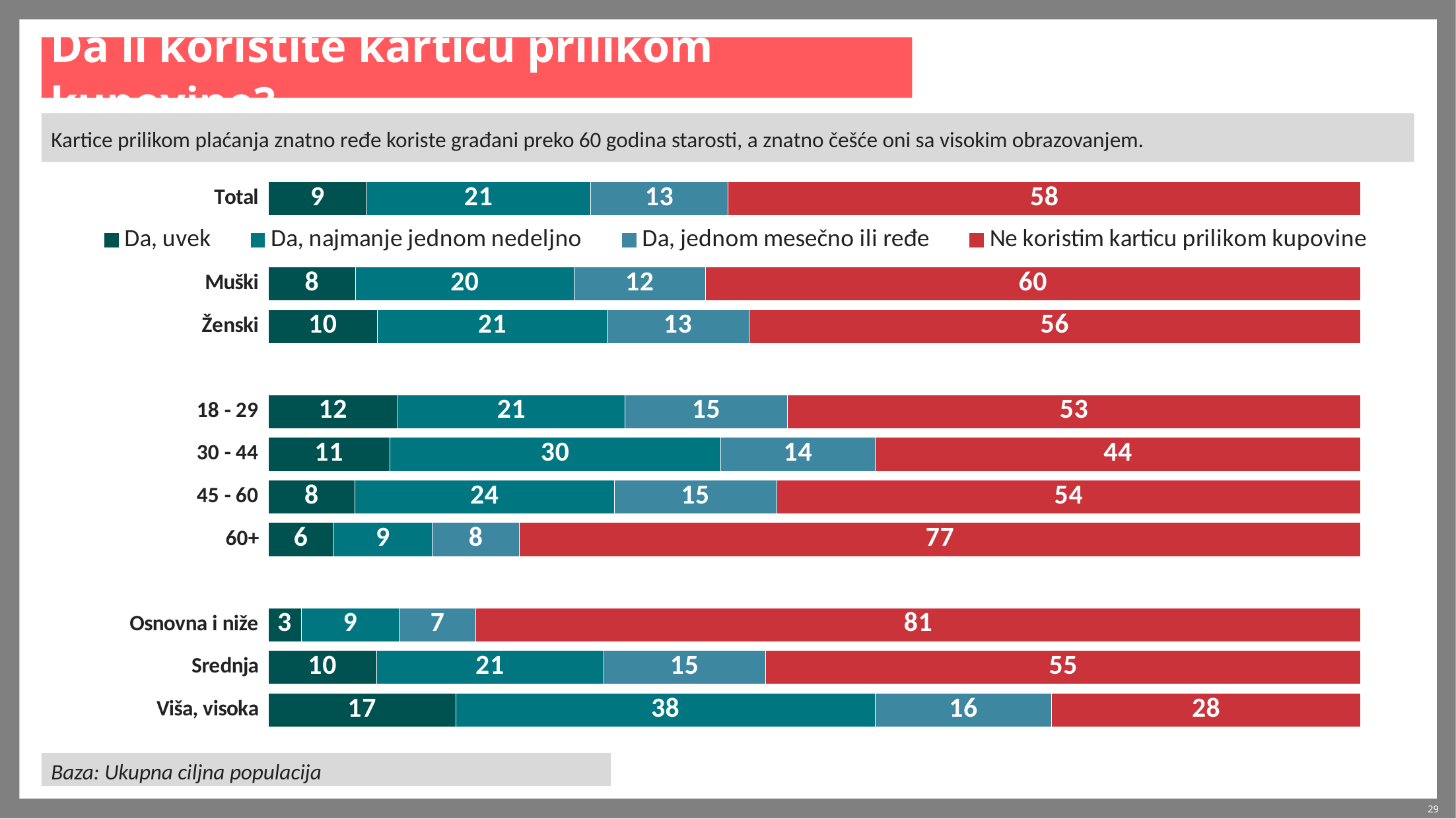
What is the value for "Da, uvek" for the Viša, visoka category? 17 Which category has the highest value for "Ne koristim karticu prilikom kupovine"? Osnovna i niže What is the total of the stacked bar for Srednja? 101 Which has a larger "Da, jednom mesečno ili ređe" value, Muški or Ženski? Ženski What is the value for "Ne koristim karticu prilikom kupovine" in the Total bar? 58 What kind of chart is shown on the slide? Stacked bar chart Which colour represents "Ne koristim karticu prilikom kupovine" in the chart? Red What is the value for "Da, najmanje jednom nedeljno" for the 30 - 44 age group? 30 What is the difference between the "Ne koristim karticu prilikom kupovine" values for 60+ and 18 - 29? 24 Which category has the lowest value for "Da, uvek"? Osnovna i niže How many category bars are shown in the chart? 10 How many series does the legend list? 4